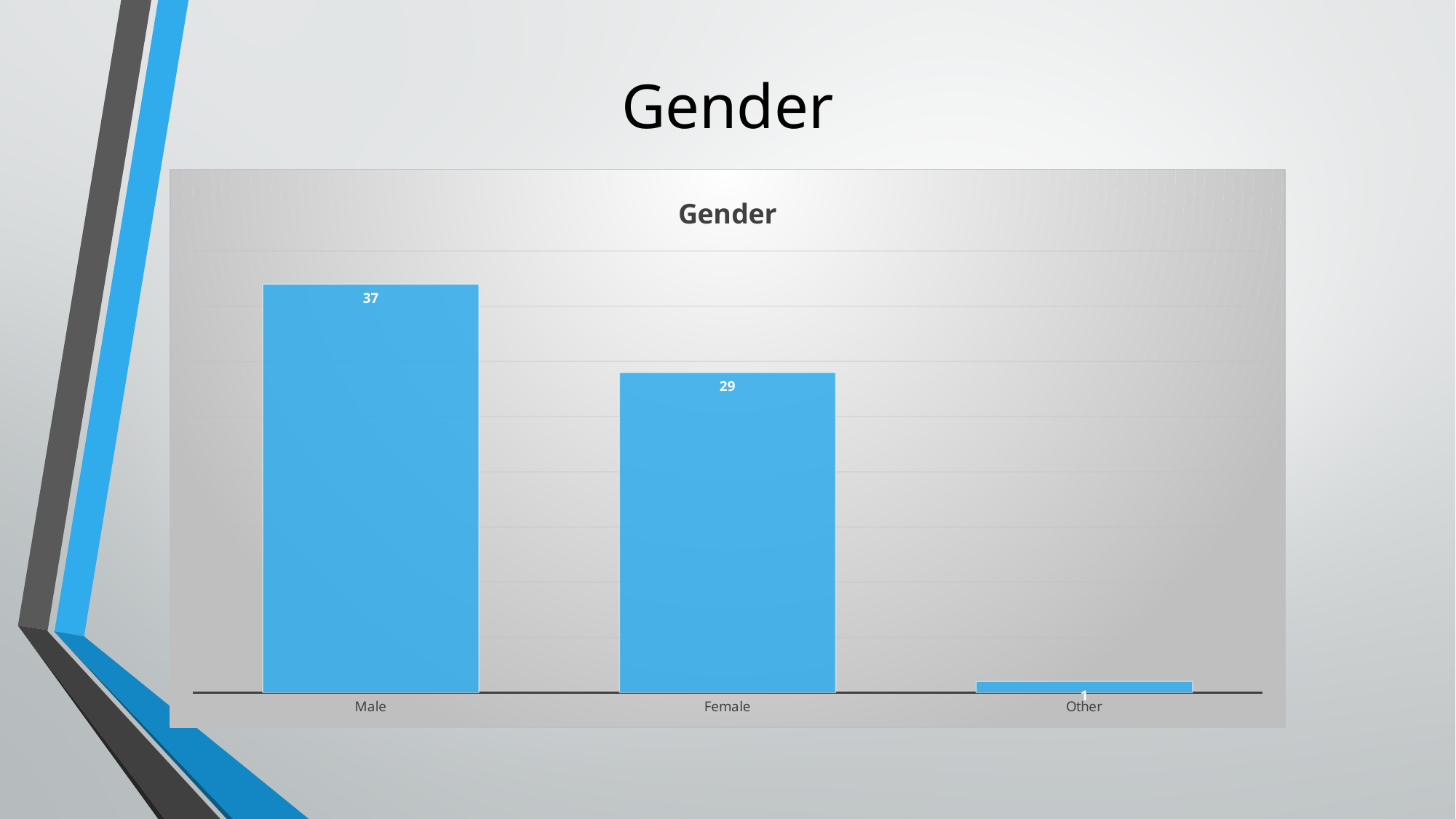
Do the values rise or fall from left to right across the categories? fall What is the title of the chart? Gender What kind of chart is shown on the slide? bar chart What is the value for Male? 37 What is the value for Female? 29 Which category has the lowest value? Other Which category has the highest value? Male What is the difference between the values for Female and Other? 28 What is the value for Other? 1 Which is larger, the value for Male or the value for Female? Male How many categories are shown on the chart? 3 What is the difference between the values for Male and Female? 8